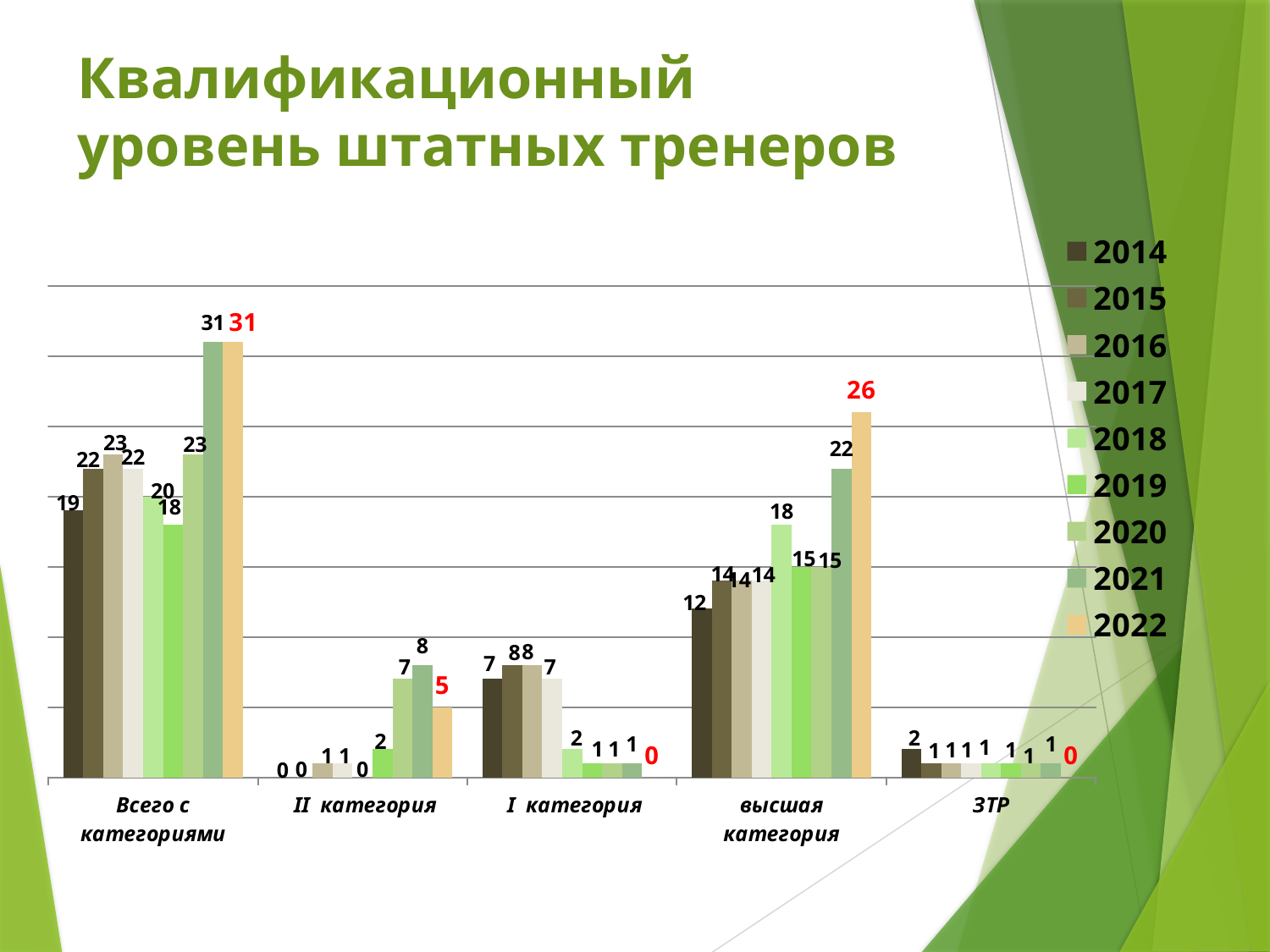
What kind of chart is shown on the slide? Bar chart What is the value for 2022 in the "I категория" group? 0 How many series does the legend list? 9 What is the title of the slide? Квалификационный уровень штатных тренеров How many category groups are shown on the x axis? 5 What is the difference between the 2022 and 2014 values in the "высшая категория" group? 14 Which is larger in the "II категория" group: the value for 2020 or the value for 2022? 2020 What is the value for 2022 in the "высшая категория" group? 26 Which year has the highest value in the "высшая категория" group? 2022 What is the value for 2014 in the "Всего с категориями" group? 19 What is the value for 2021 in the "II категория" group? 8 Which year has the lowest value in the "Всего с категориями" group? 2019